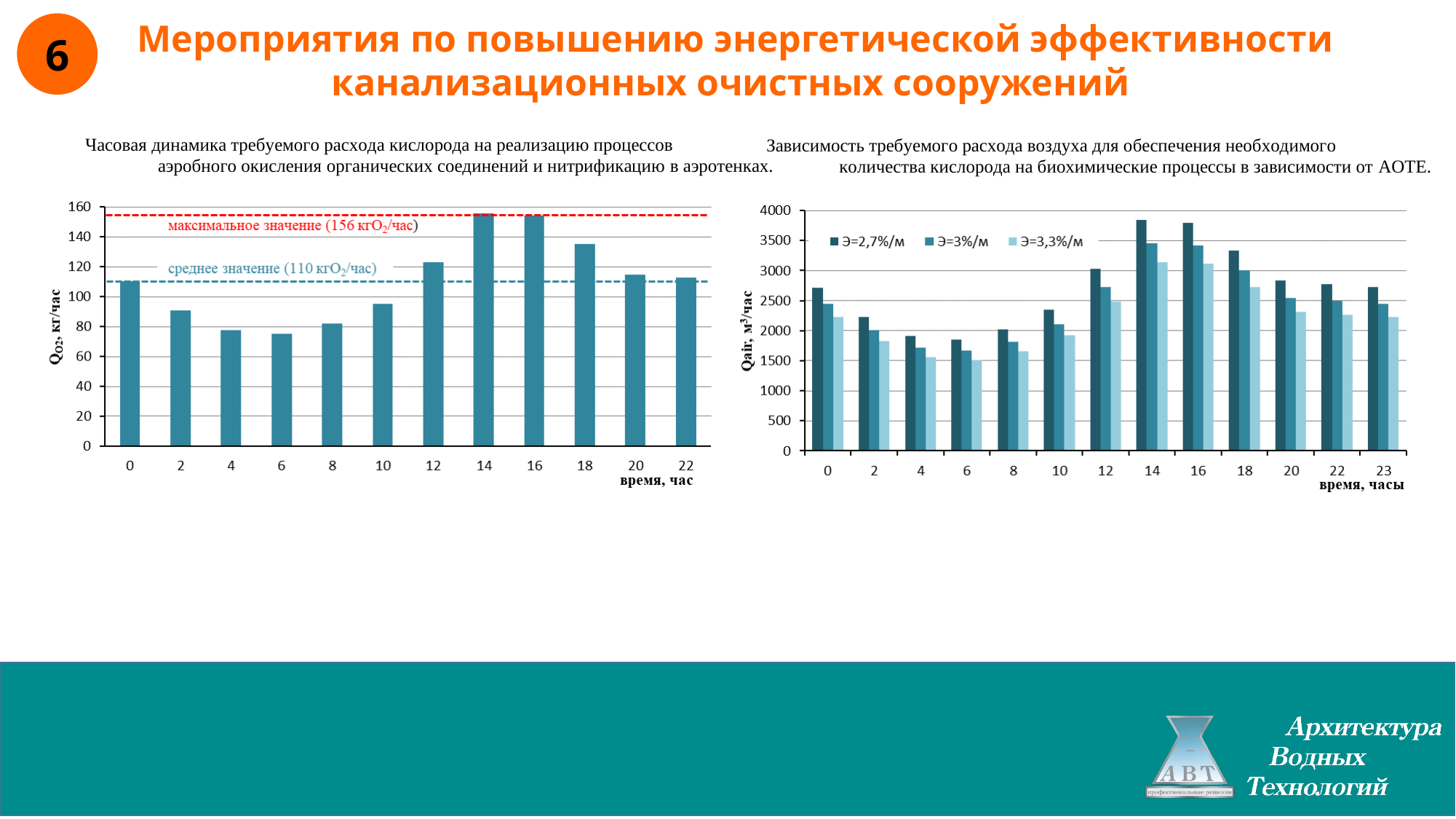
What kind of chart is the left chart (Часовая динамика требуемого расхода кислорода)? bar chart On the right chart, at hour 12, which series is larger: Э=2,7%/м or Э=3,3%/м? Э=2,7%/м On the left chart, what average value is stated by the blue dashed line annotation? 110 кгО2/час How many series does the legend of the right chart (Зависимость требуемого расхода воздуха) list? 3 On the left chart, is the value at hour 6 greater or less than 80? less How many time categories are shown on the x axis of the right chart? 13 On the left chart, is the value at hour 10 greater or less than 100? less On the right chart, is the value of Э=2,7%/м at hour 14 greater or less than 3500? greater On the left chart, what maximum value is stated by the red dashed line annotation? 156 кгО2/час On the right chart, do the values of Э=2,7%/м rise or fall from hour 0 to hour 6? fall How many time categories are shown on the x axis of the left chart? 12